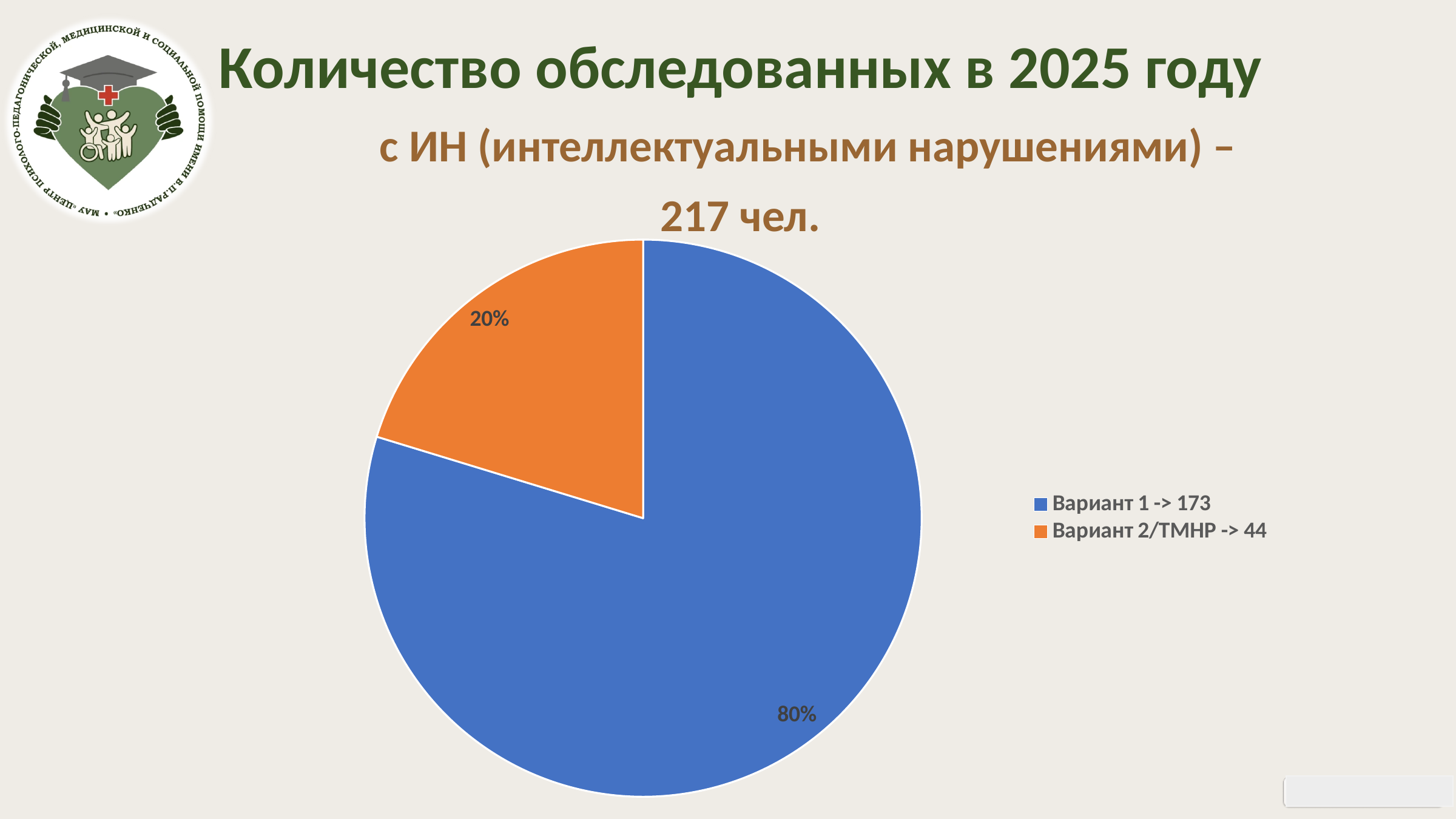
What percentage of the pie does the "Вариант 1 -> 173" slice represent? 80% Which is larger: the share for "Вариант 1" or the share for "Вариант 2/ТМНР"? Вариант 1 How many slices does the pie chart have? 2 What colour is the "Вариант 1 -> 173" slice? blue What colour is the "Вариант 2/ТМНР -> 44" slice? orange How many entries does the legend list? 2 What percentage of the pie does the "Вариант 2/ТМНР -> 44" slice represent? 20% What total number of people is stated in the chart title? 217 чел. What kind of chart is shown on the slide? pie chart Which slice is the smallest in the pie chart? Вариант 2/ТМНР -> 44 What is the difference in percentage points between the 80% slice and the 20% slice? 60 percentage points Which slice is the largest in the pie chart? Вариант 1 -> 173